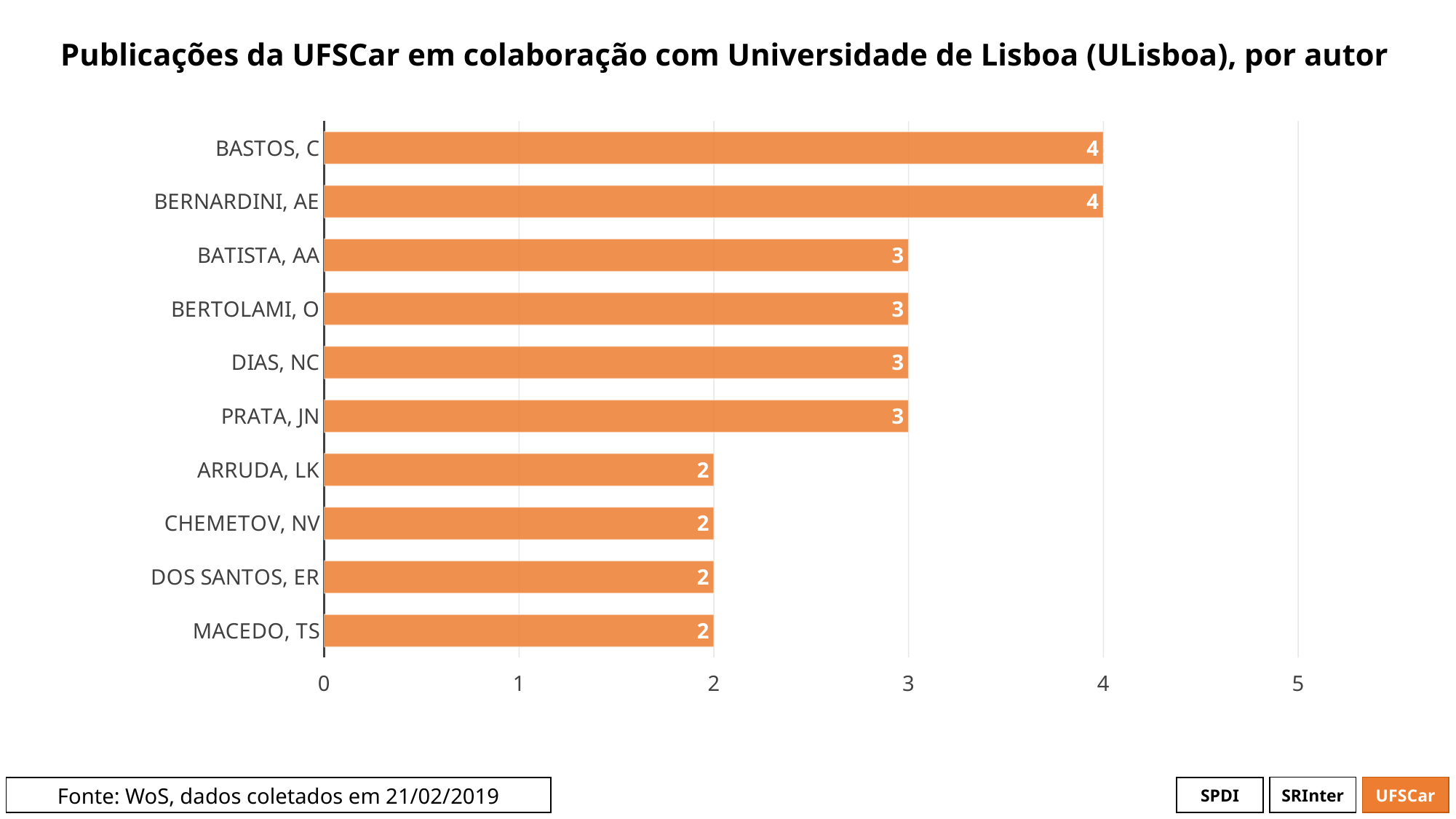
What kind of chart is shown on the slide? bar chart What is the value for MACEDO, TS? 2 How many authors have a value of 3? 4 How many authors are shown in the chart? 10 Which author has the lowest value among BATISTA, AA, PRATA, JN and ARRUDA, LK? ARRUDA, LK What is the value for DIAS, NC? 3 What is the difference between the values for BERNARDINI, AE and CHEMETOV, NV? 2 Which is larger, the value for BATISTA, AA or the value for DOS SANTOS, ER? BATISTA, AA What is the title of the chart? Publicações da UFSCar em colaboração com Universidade de Lisboa (ULisboa), por autor How many publications does BASTOS, C have? 4 What is the value for BERTOLAMI, O? 3 Is the value for PRATA, JN greater or less than 2? greater